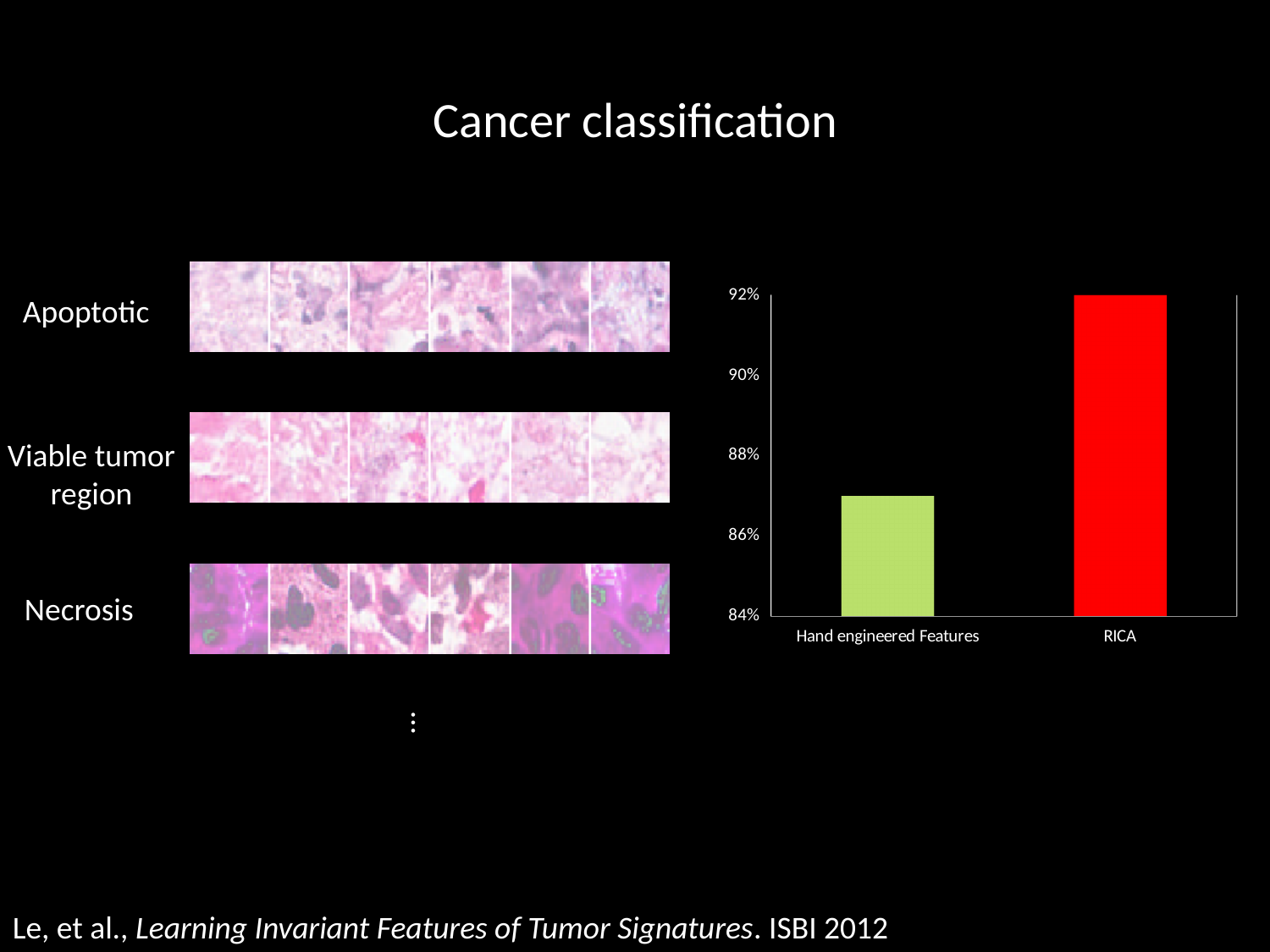
Which is larger, the value for RICA or the value for Hand engineered Features? RICA What colour is the bar for RICA? red Which category has the highest value in the bar chart? RICA Which category has the lowest value in the bar chart? Hand engineered Features What value does the RICA bar reach on the y axis? 92% How many categories are plotted in the bar chart? 2 Is the value for Hand engineered Features greater or less than 86%? greater Is the value for Hand engineered Features greater or less than 88%? less Is the value for RICA greater or less than 90%? greater What is the lowest value shown on the y axis of the bar chart? 84% What kind of chart is shown on the slide? bar chart